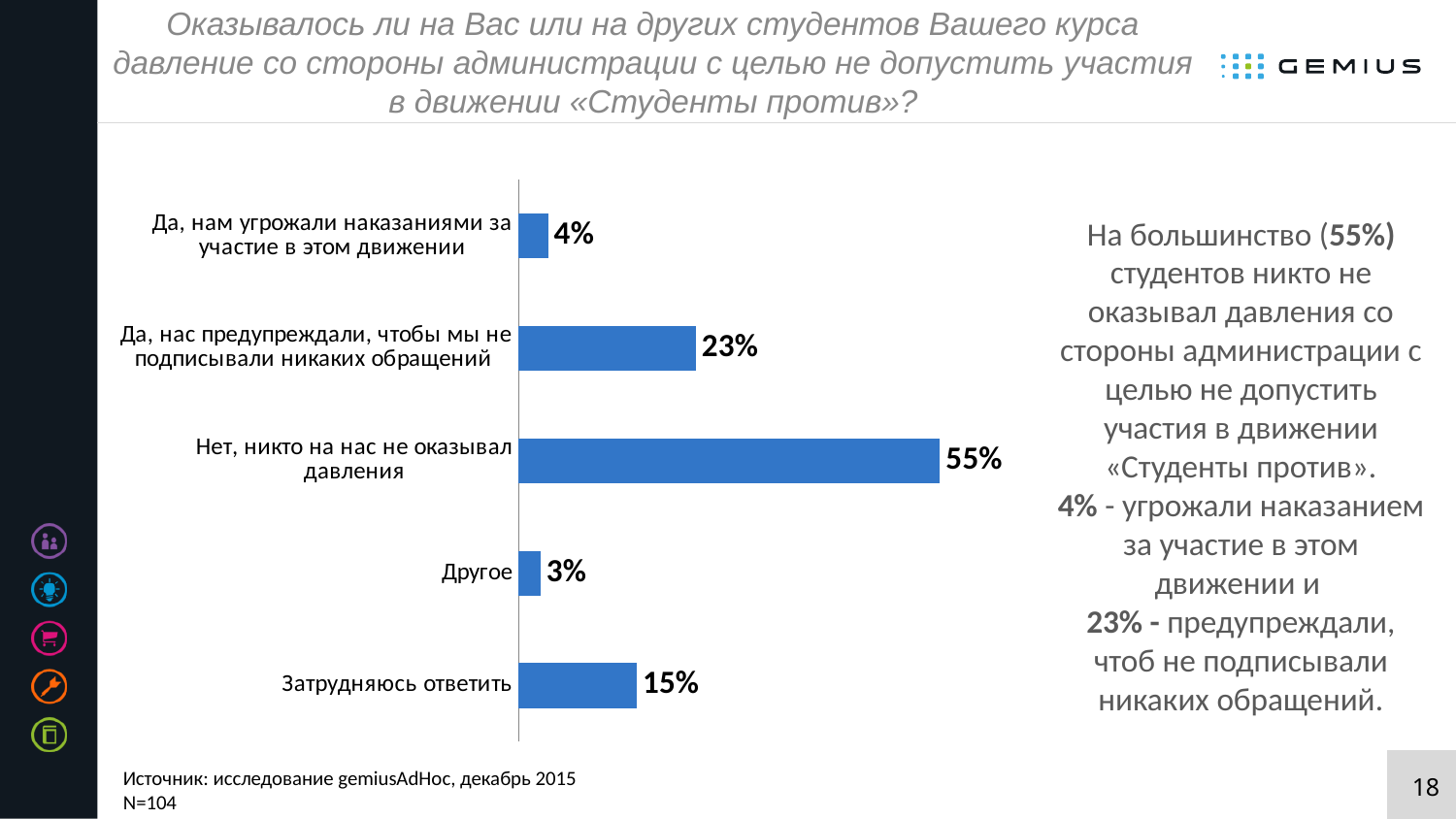
Which is larger: the value for «Затрудняюсь ответить» or the value for «Да, нас предупреждали, чтобы мы не подписывали никаких обращений»? Да, нас предупреждали, чтобы мы не подписывали никаких обращений What type of chart is shown on the slide? Bar chart Which category has the highest value in the chart? Нет, никто на нас не оказывал давления What is the difference between the values for «Нет, никто на нас не оказывал давления» and «Да, нас предупреждали, чтобы мы не подписывали никаких обращений»? 32% Which category has the lowest value in the chart? Другое What percentage is shown for «Затрудняюсь ответить»? 15% What value is shown for «Да, нам угрожали наказаниями за участие в этом движении»? 4% How many categories are shown in the chart? 5 What is the combined value of «Да, нам угрожали наказаниями за участие в этом движении» and «Да, нас предупреждали, чтобы мы не подписывали никаких обращений»? 27% What is the sample size (N) stated on the slide? N=104 What percentage of respondents answered «Нет, никто на нас не оказывал давления»? 55% What value is shown for «Другое»? 3%